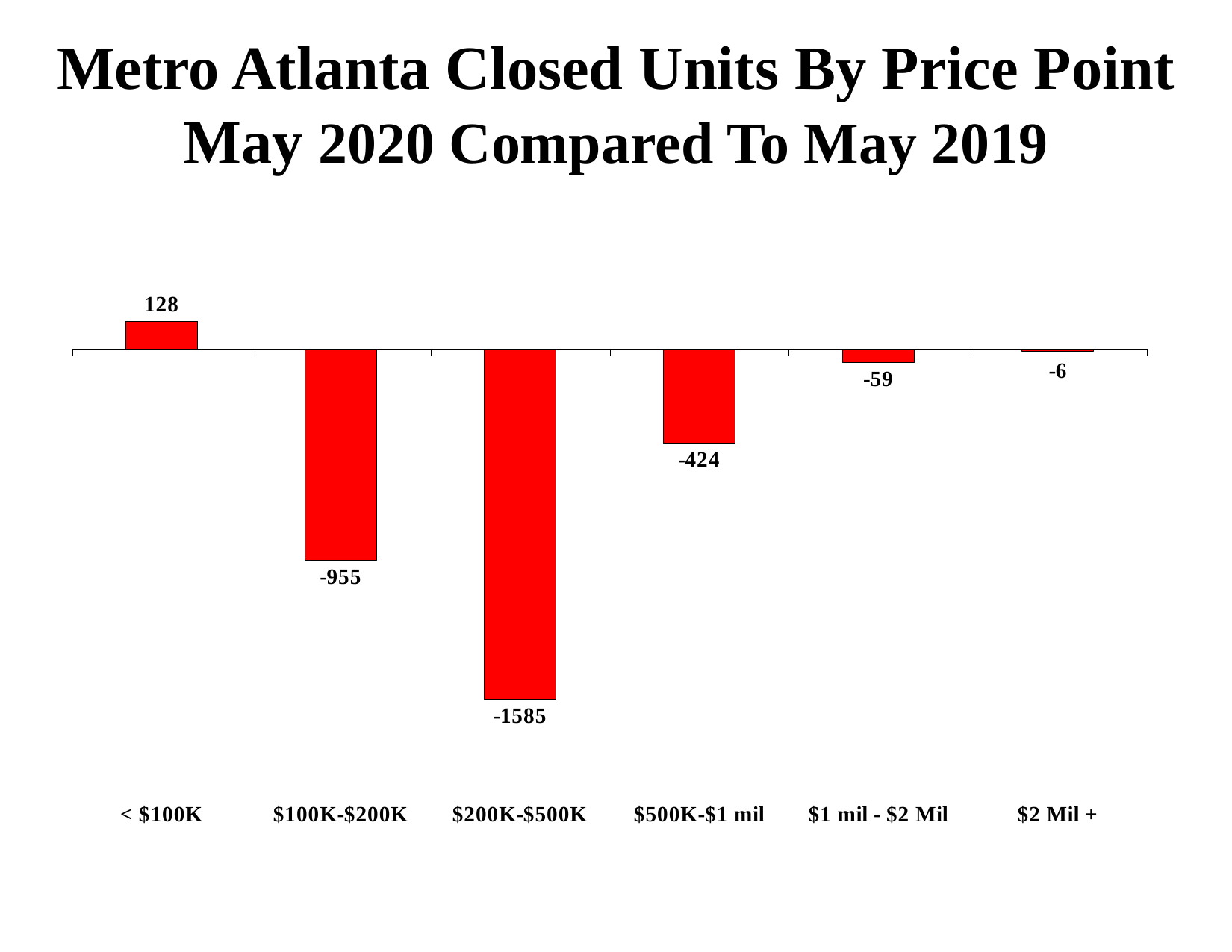
What is the value for the $2 Mil + price point? -6 How many price point categories are shown on the chart? 6 What is the value for the $1 mil - $2 Mil price point? -59 What is the value for the < $100K price point? 128 Which price point has the highest value? < $100K What is the title of the chart? Metro Atlanta Closed Units By Price Point May 2020 Compared To May 2019 What is the difference between the values for $100K-$200K and $500K-$1 mil? 531 Which has the larger value, $500K-$1 mil or $1 mil - $2 Mil? $1 mil - $2 Mil How many price points have a positive value? 1 Which price point has the lowest value? $200K-$500K What kind of chart is shown on the slide? Bar chart What is the value for the $200K-$500K price point? -1585